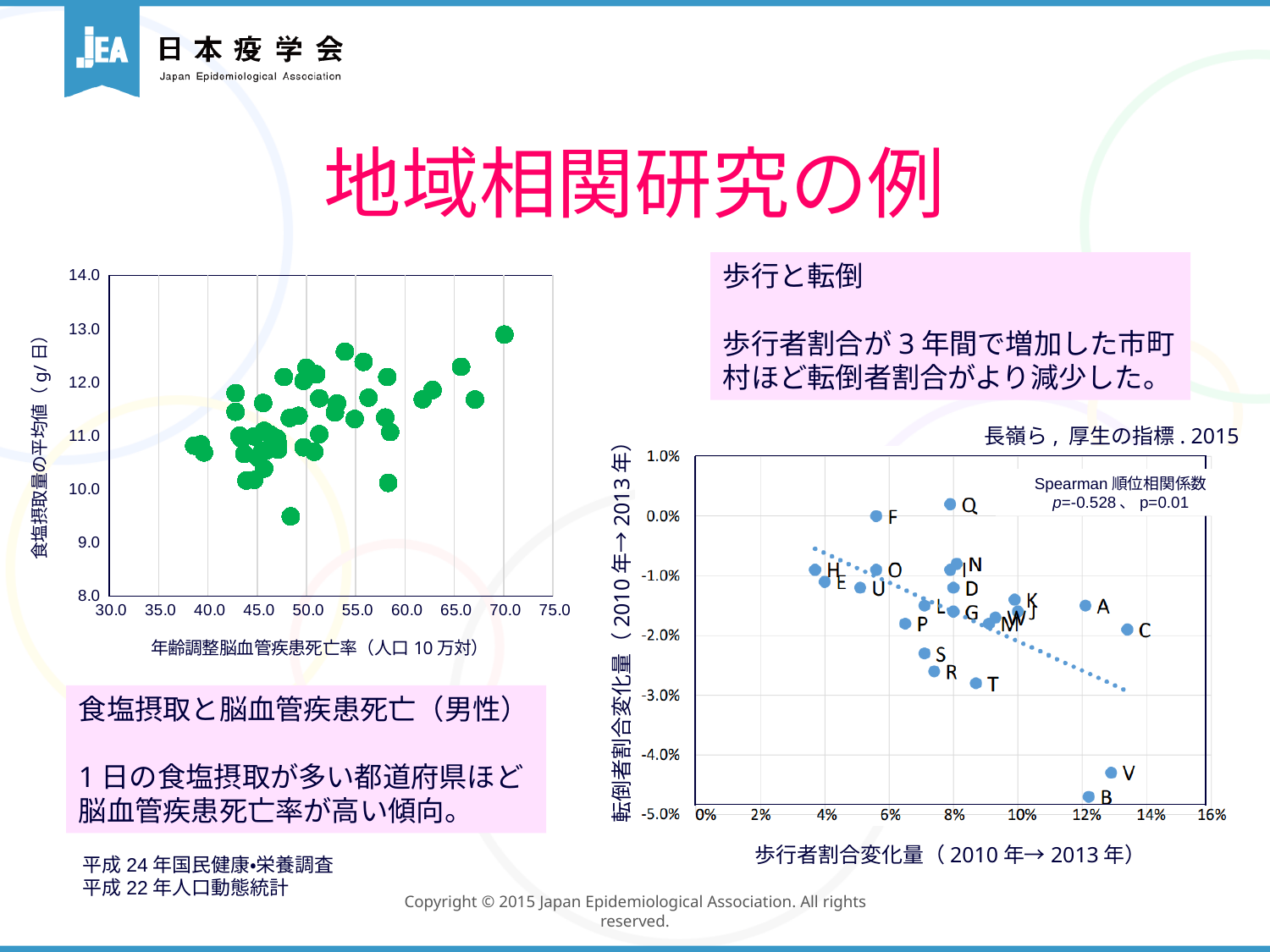
In the right chart (歩行と転倒), is the horizontal-axis value for point C greater or less than 12%? greater In the right chart (歩行と転倒), do the values on the vertical axis tend to rise or fall as the horizontal-axis value increases? fall In the right chart (歩行と転倒), which point has the higher vertical-axis value, A or V? A In the right chart (歩行と転倒), which labeled point has the highest value on the vertical axis (転倒者割合変化量)? Q In the right chart (歩行と転倒), is the vertical-axis value for point T greater or less than -2.0%? less What Spearman rank correlation coefficient (ρ) is printed on the right chart (歩行と転倒)? -0.528 What kind of chart is the chart on the right of the slide (歩行と転倒)? scatter chart In the right chart (歩行と転倒), which labeled point has the lowest value on the vertical axis (転倒者割合変化量)? B In the right chart (歩行と転倒), is the vertical-axis value for point V greater or less than -4.0%? less In the left chart (食塩摂取と脳血管疾患死亡), do the salt intake values tend to rise or fall as the mortality rate on the x axis increases? rise What kind of chart is the chart on the left of the slide (食塩摂取と脳血管疾患死亡)? scatter chart